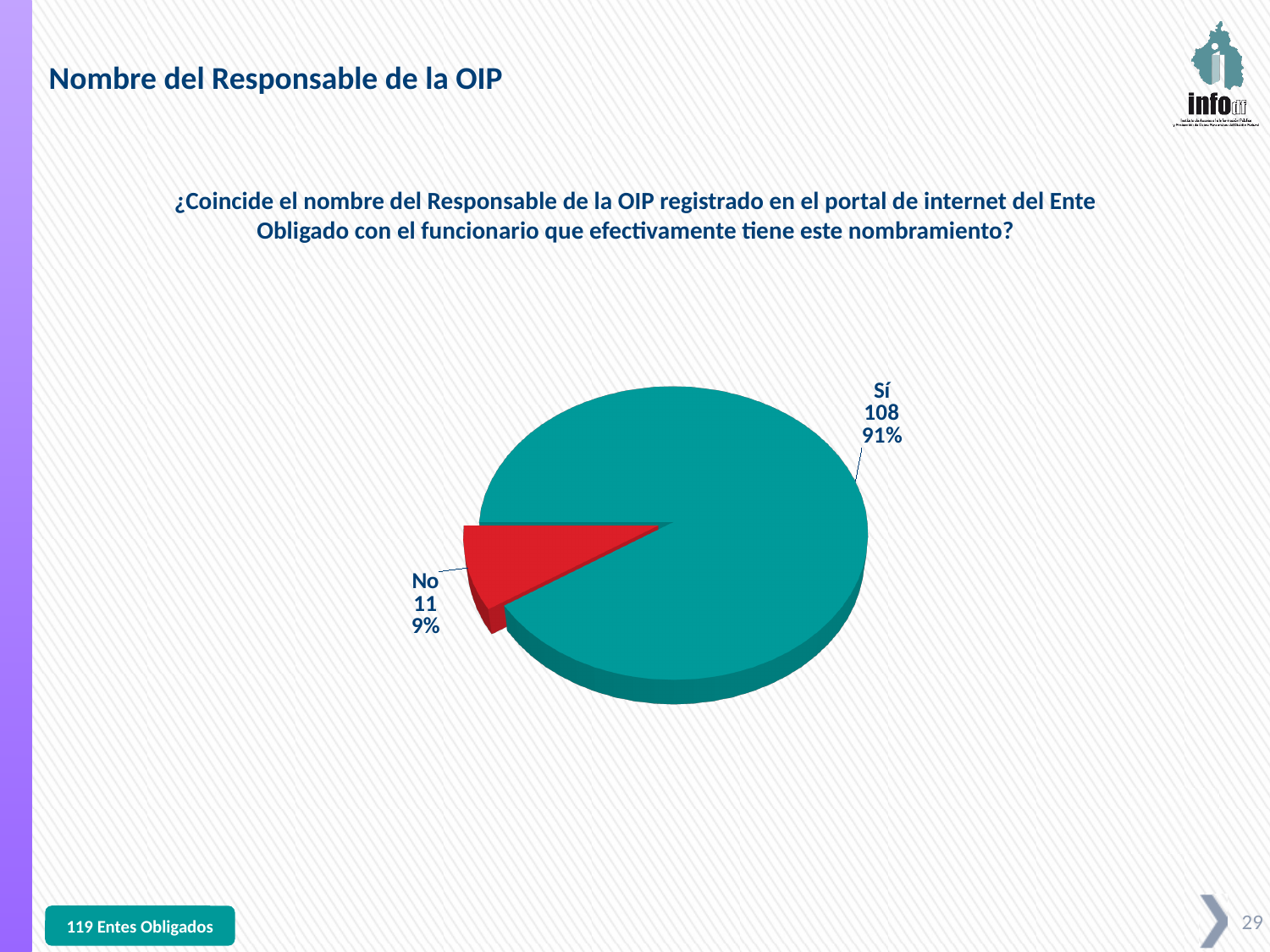
What kind of chart is shown on the slide? pie chart How many slices does the pie chart have? 2 What colour is the "No" slice? red Which slice is the largest? Sí Which slice is the smallest? No What is the value for the "Sí" slice? 108 What is the difference between the "Sí" and "No" values? 97 What is the total of the two slices in the pie chart? 119 Which is larger, the "Sí" slice or the "No" slice? Sí What share of the pie does the "Sí" slice represent? 91% What share of the pie does the "No" slice represent? 9% What is the value for the "No" slice? 11